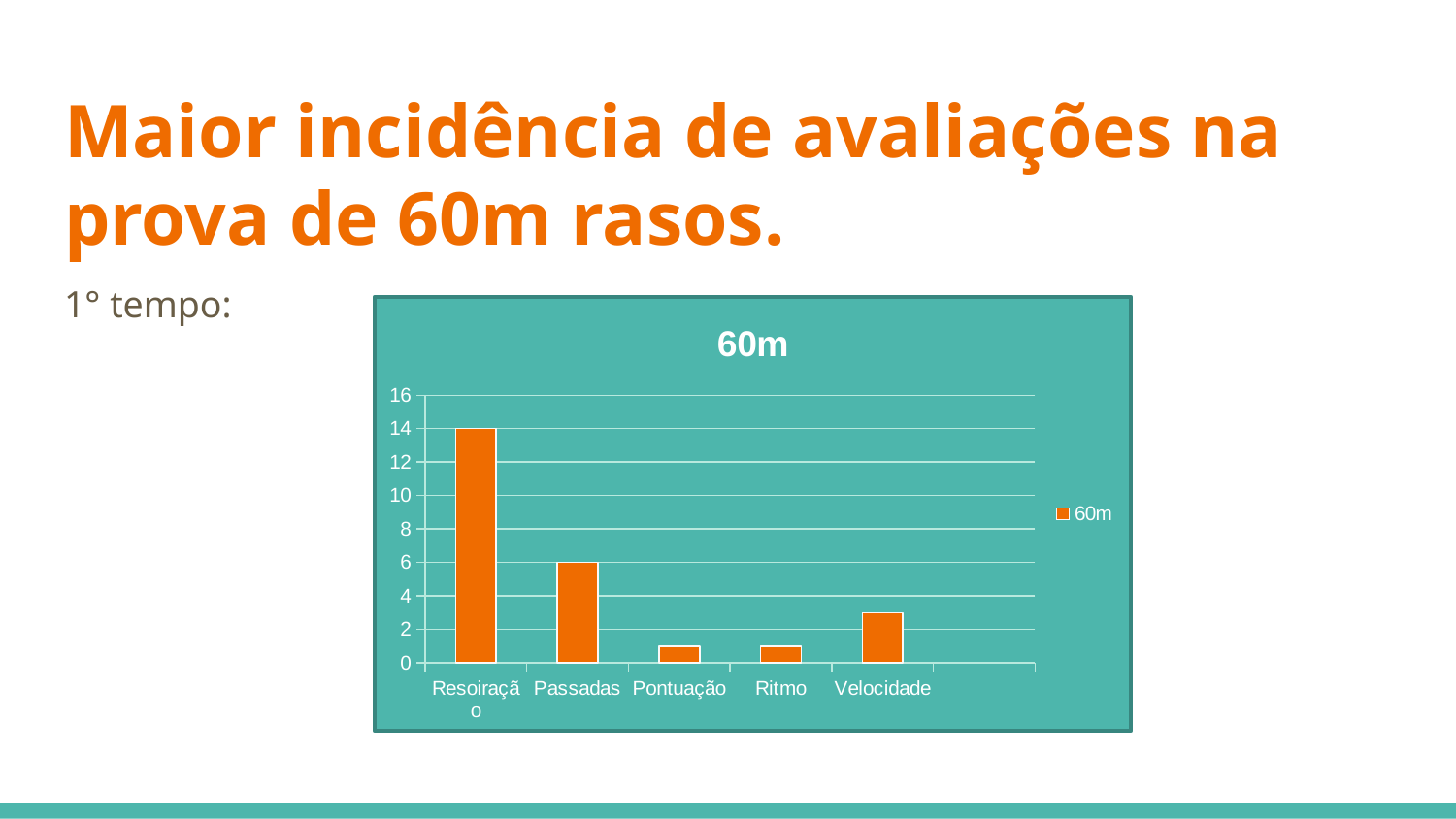
Is the value for Pontuação greater or less than 2? less Which is larger, the value for Passadas or the value for Velocidade? Passadas Which category has the highest value in the chart? Resoiração What is the title of the chart? 60m What is the value for Passadas in the chart? 6 What is the value for Resoiração in the chart? 14 What is the difference between the values for Resoiração and Passadas? 8 How many series does the chart legend list? 1 How many categories are shown on the x axis of the chart? 5 What colour are the bars in the chart? orange Is the value for Velocidade greater or less than 2? greater What type of chart is shown on the slide? bar chart